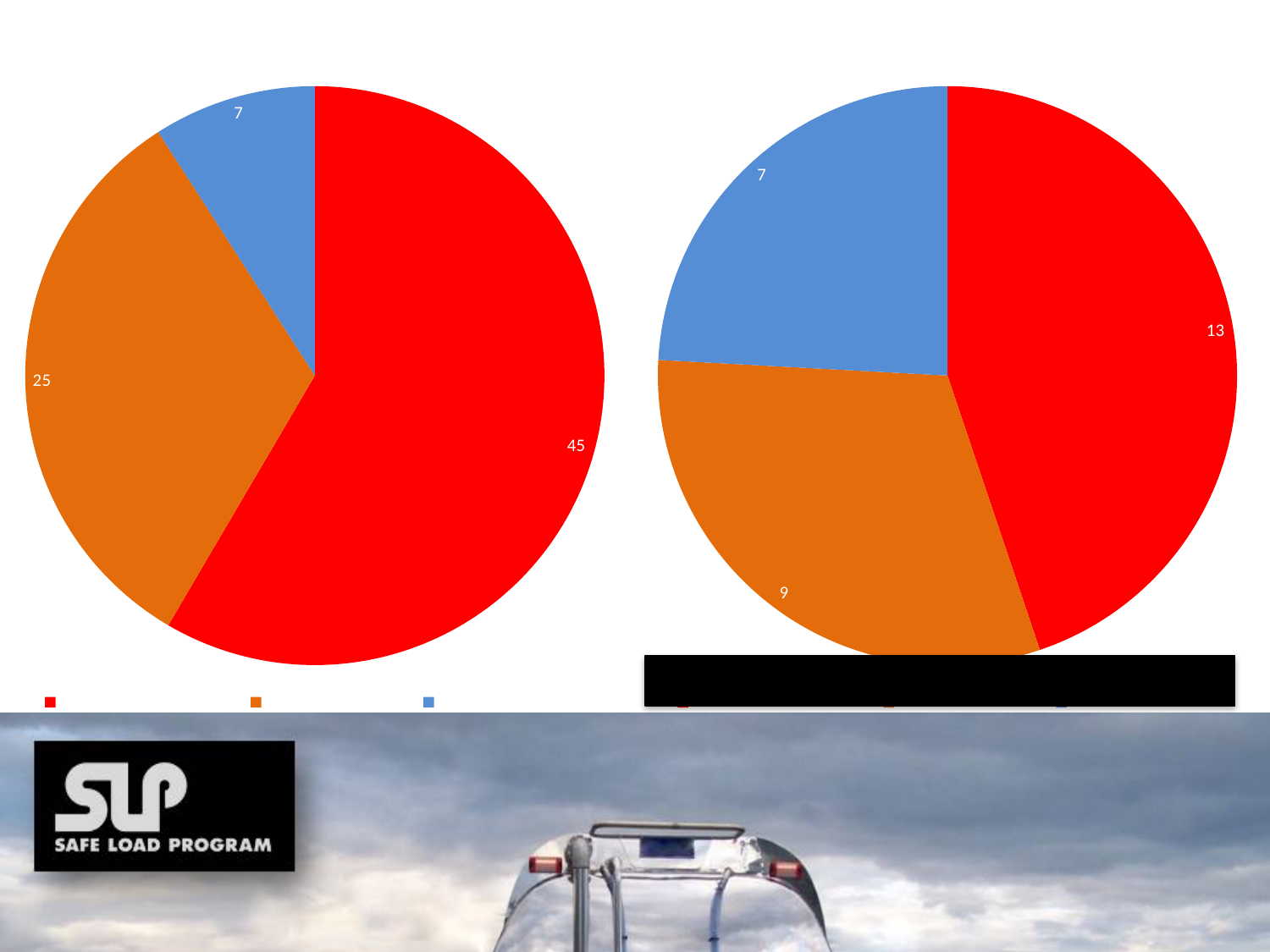
How many slices does the right pie chart have? 3 In the left pie chart, what is the value of the orange slice? 25 In the right pie chart, what is the value of the red slice? 13 In the right pie chart, what is the value of the orange slice? 9 Which is larger: the red slice in the left pie chart or the red slice in the right pie chart? the red slice in the left pie chart In the right pie chart, what is the difference between the red slice and the orange slice? 4 In the left pie chart, what is the difference between the red slice and the orange slice? 20 In the left pie chart, which colour slice is the smallest? blue What kind of chart is the chart on the left of the slide? pie chart In the right pie chart, what is the value of the blue slice? 7 In the left pie chart, what is the value of the red slice? 45 In the left pie chart, which colour slice is the largest? red